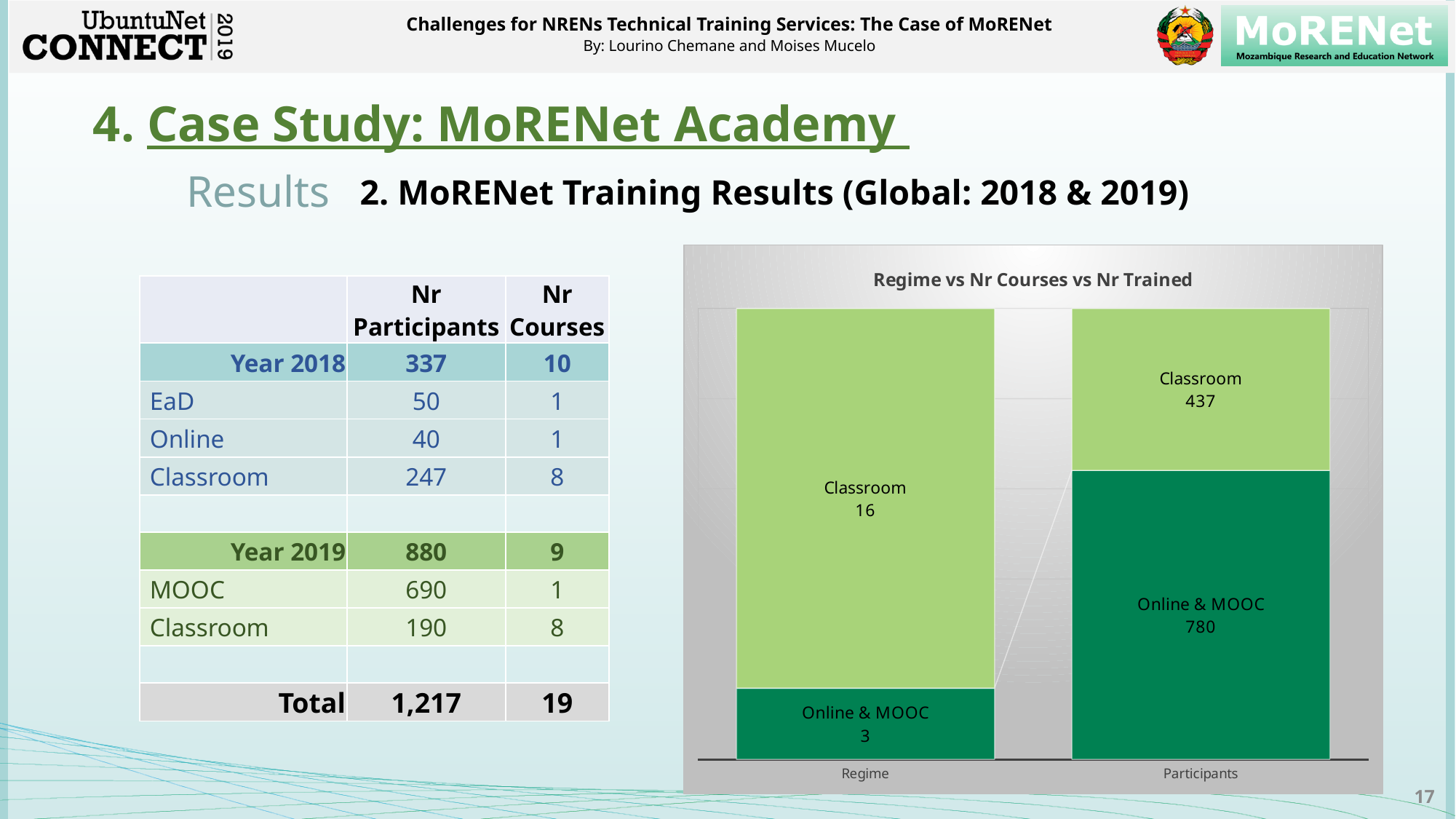
What is the difference between the Classroom and Online & MOOC values in the Regime bar? 13 In the Participants bar, which segment is larger: Classroom or Online & MOOC? Online & MOOC In the chart, what is the Classroom value in the Participants bar? 437 In the chart, what is the Classroom value in the Regime bar? 16 In the chart, what is the Online & MOOC value in the Regime bar? 3 What is the total of the Participants stacked bar in the chart? 1217 What is the total of the Regime stacked bar in the chart? 19 In the chart, what is the Online & MOOC value in the Participants bar? 780 What is the difference between the Online & MOOC and Classroom values in the Participants bar? 343 What is the title of the chart? Regime vs Nr Courses vs Nr Trained What kind of chart is shown on the slide? stacked bar chart How many bars (categories) are shown on the x axis of the chart? 2